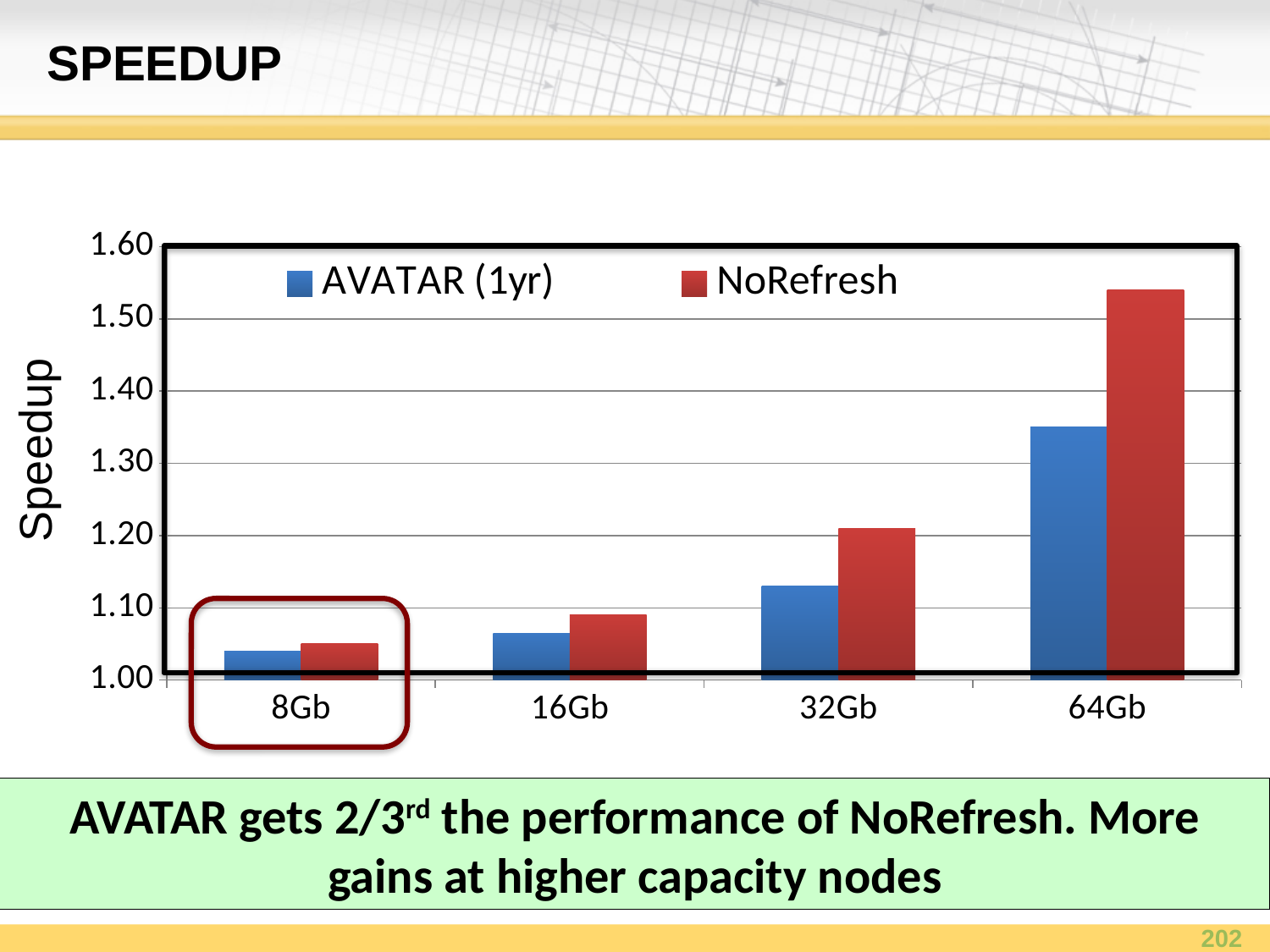
Which capacity has the highest NoRefresh speedup? 64Gb Which capacity has the lowest AVATAR (1yr) speedup? 8Gb At 32Gb, which series has the larger speedup, AVATAR (1yr) or NoRefresh? NoRefresh Is the AVATAR (1yr) speedup at 64Gb greater or less than 1.30? greater How many series does the legend list? 2 At 64Gb, which series has the larger speedup, AVATAR (1yr) or NoRefresh? NoRefresh Do the speedup values for NoRefresh rise or fall as capacity increases from 8Gb to 64Gb? rise What kind of chart is shown on the slide? bar chart How many capacity categories are shown on the x axis? 4 Is the NoRefresh speedup at 64Gb greater or less than 1.50? greater Is the AVATAR (1yr) speedup at 16Gb greater or less than 1.10? less What is the label on the y axis of the chart? Speedup